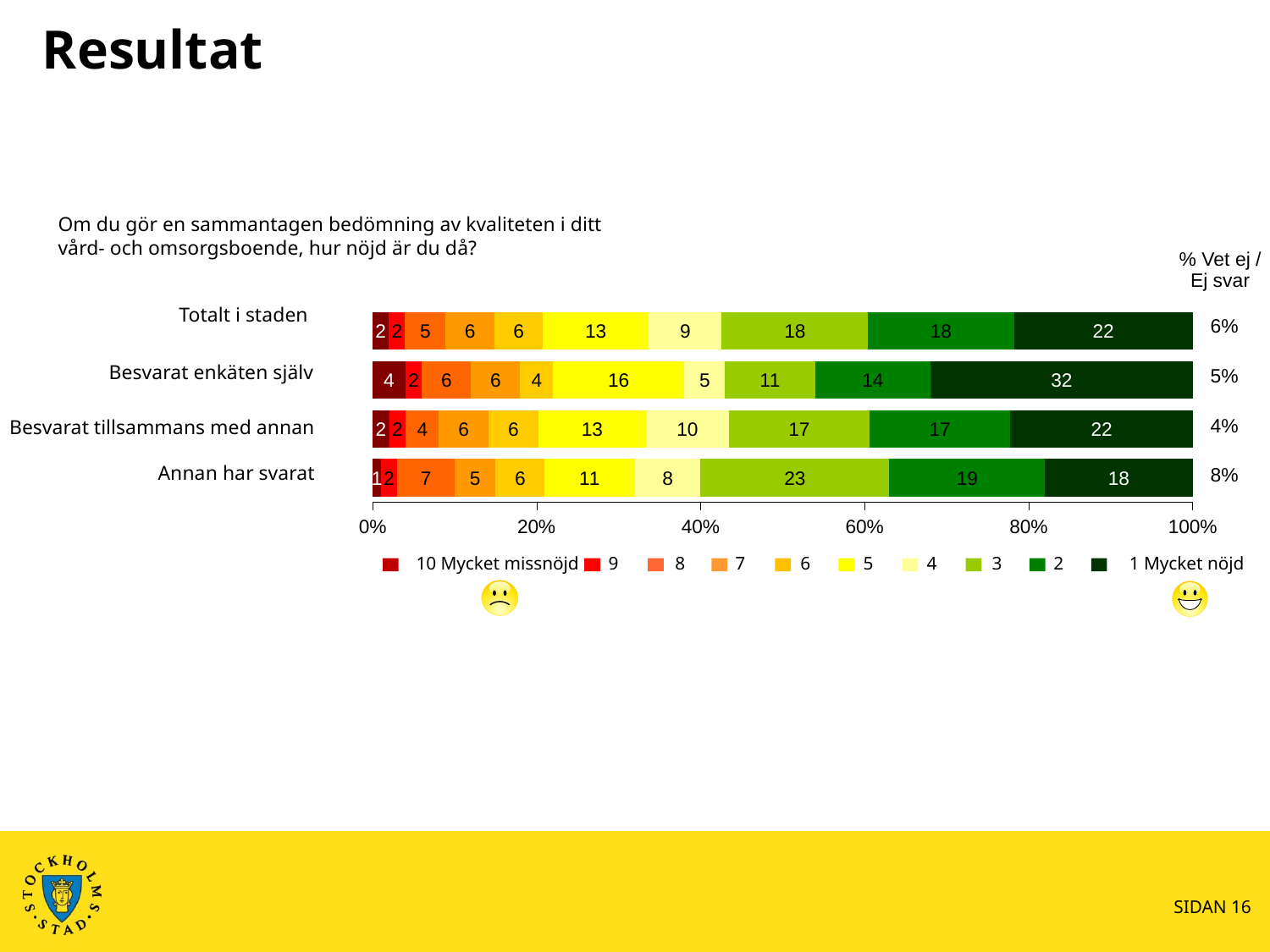
How many categories (bars) are shown in the chart? 4 What is the difference between the "1 Mycket nöjd" values for "Besvarat enkäten själv" and "Totalt i staden"? 10 What is the value for "1 Mycket nöjd" in the "Besvarat enkäten själv" bar? 32 What is the value for "10 Mycket missnöjd" in the "Besvarat enkäten själv" bar? 4 Which category has the lowest value for "1 Mycket nöjd"? Annan har svarat What is the "% Vet ej / Ej svar" value shown for "Annan har svarat"? 8% How many series does the legend list? 10 What is the value for "3" in the "Annan har svarat" bar? 23 Which has the larger value for "5": "Besvarat enkäten själv" or "Annan har svarat"? Besvarat enkäten själv Which legend entry is shown in the darkest green colour? 1 Mycket nöjd Which category has the highest value for "1 Mycket nöjd"? Besvarat enkäten själv What kind of chart is shown on the slide? Stacked bar chart